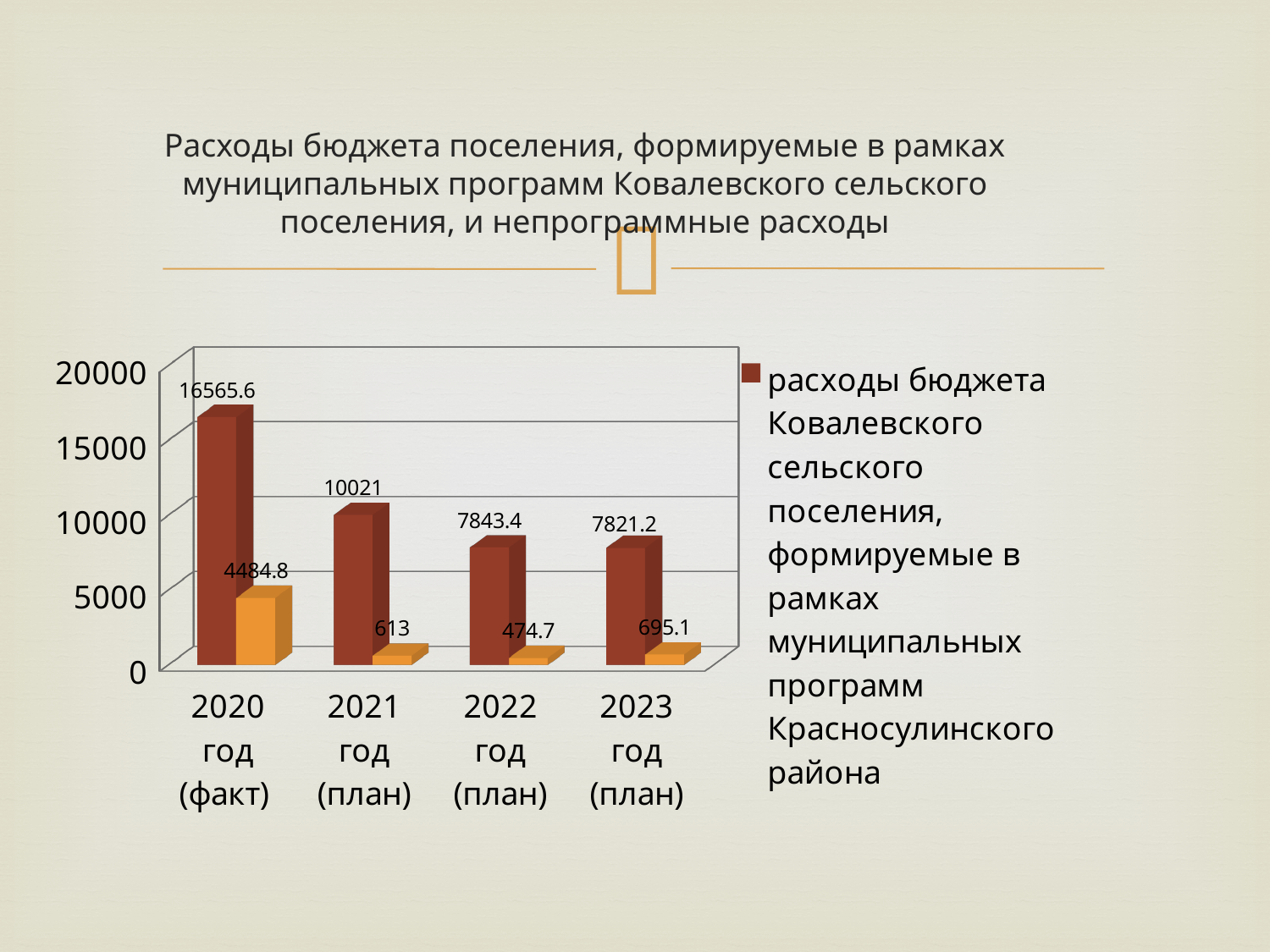
What is the difference between the brown series values for 2020 год (факт) and 2021 год (план)? 6544.6 What is the value of the orange series for 2021 год (план)? 613 Which is larger: the brown series value for 2021 год (план) or for 2022 год (план)? 2021 год (план) How many year categories are shown on the x axis? 4 Is the brown series value for 2020 год (факт) greater or less than 15000? greater Which year has the highest value for the brown series? 2020 год (факт) What is the value of the brown series (расходы бюджета, формируемые в рамках муниципальных программ) for 2020 год (факт)? 16565.6 What is the difference between the orange series values for 2023 год (план) and 2022 год (план)? 220.4 What is the value of the orange series for 2022 год (план)? 474.7 What is the value of the brown series for 2023 год (план)? 7821.2 Which year has the lowest value for the orange series? 2022 год (план) What kind of chart is shown on the slide? Bar chart